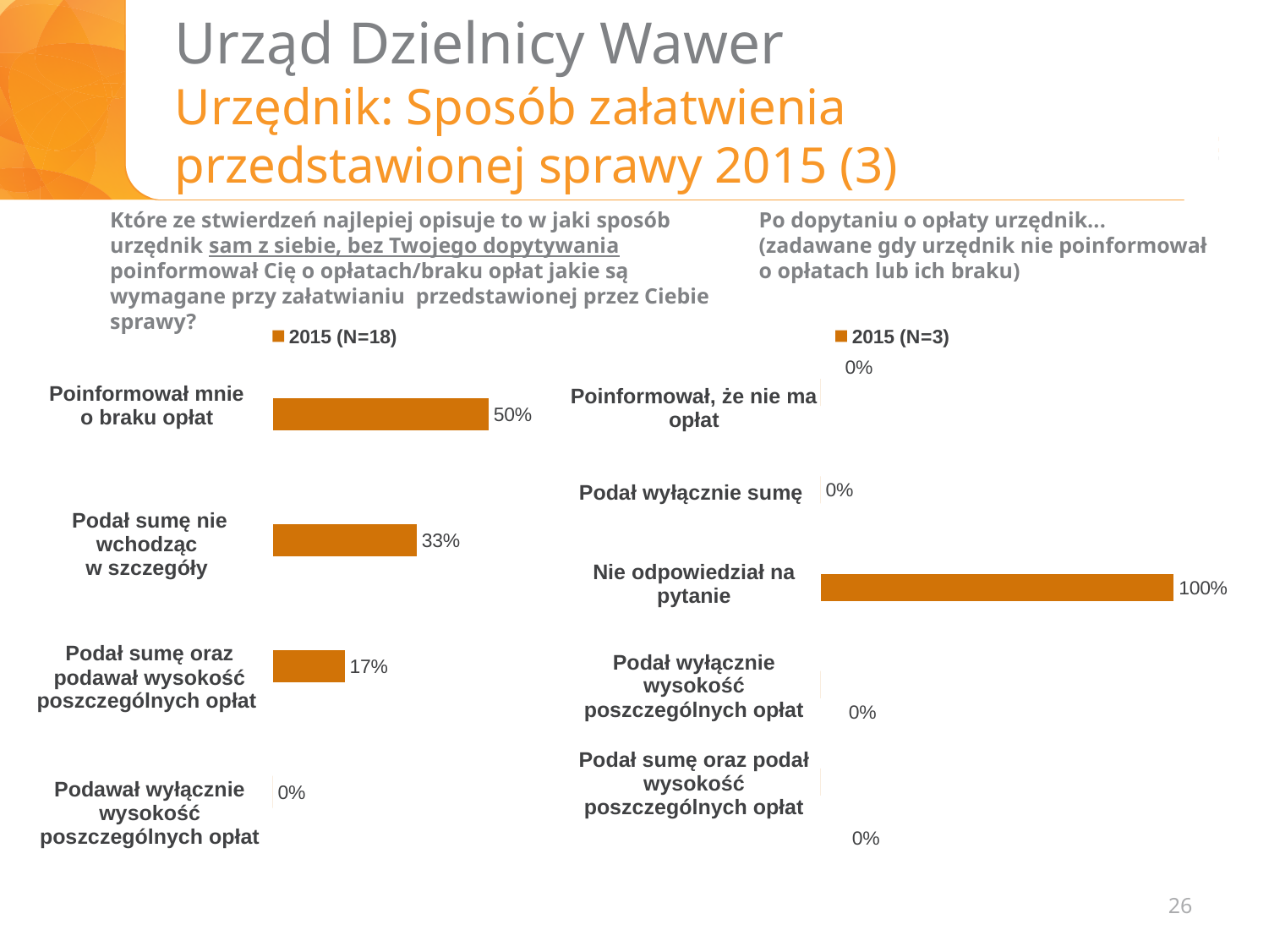
In the right chart, which category has the highest value? Nie odpowiedział na pytanie In the left chart, what is the value for "Poinformował mnie o braku opłat"? 50% In the right chart, how many categories are shown? 5 In the right chart, what is the value for "Nie odpowiedział na pytanie"? 100% What type of chart is the left chart? Bar chart In the left chart, what is the value for "Podał sumę oraz podawał wysokość poszczególnych opłat"? 17% In the left chart, what is the difference between "Poinformował mnie o braku opłat" and "Podał sumę nie wchodząc w szczegóły"? 17% In the right chart, what is the value for "Podał wyłącznie sumę"? 0% In the left chart, how many categories are shown? 4 In the left chart, what is the value for "Podał sumę nie wchodząc w szczegóły"? 33% In the left chart, which category has the highest value? Poinformował mnie o braku opłat In the left chart, which category has the lowest value? Podawał wyłącznie wysokość poszczególnych opłat